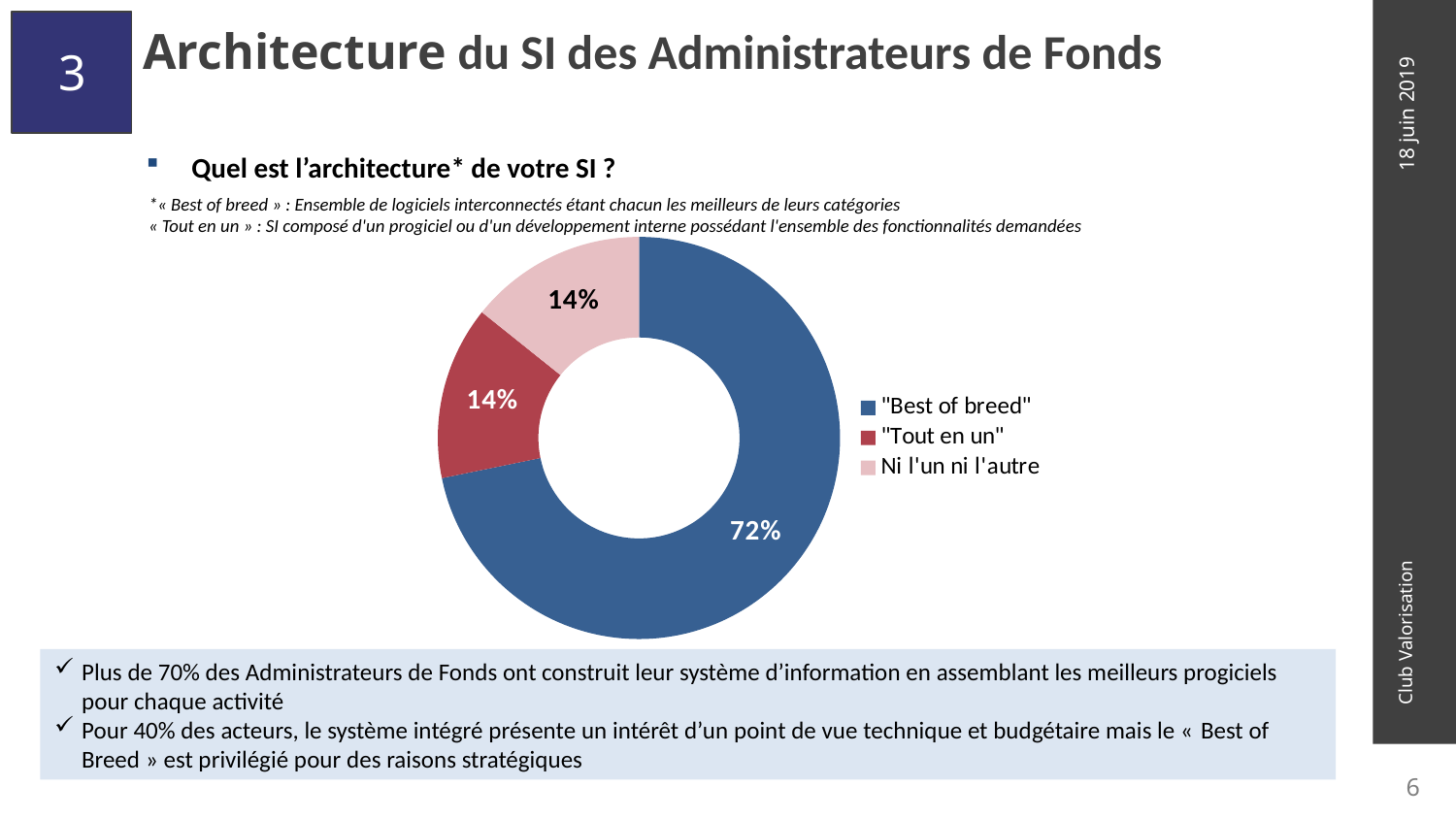
What colour is the "Best of breed" slice in the pie chart? Blue What is the difference in percentage points between the "Best of breed" slice and the "Tout en un" slice? 58 percentage points What share of the pie chart is labelled "Best of breed"? 72% How many entries does the chart legend list? 3 Which slice is larger, "Best of breed" or "Ni l'un ni l'autre"? "Best of breed" What share of the pie chart is labelled "Ni l'un ni l'autre"? 14% What question does the chart on the slide answer, according to the bullet above it? Quel est l'architecture* de votre SI ? Is the share for "Best of breed" greater or less than 50%? greater How many slices does the pie chart have? 3 What share of the pie chart is labelled "Tout en un"? 14% What kind of chart is shown on the slide? Pie chart (donut) Which category has the largest slice in the pie chart? "Best of breed"